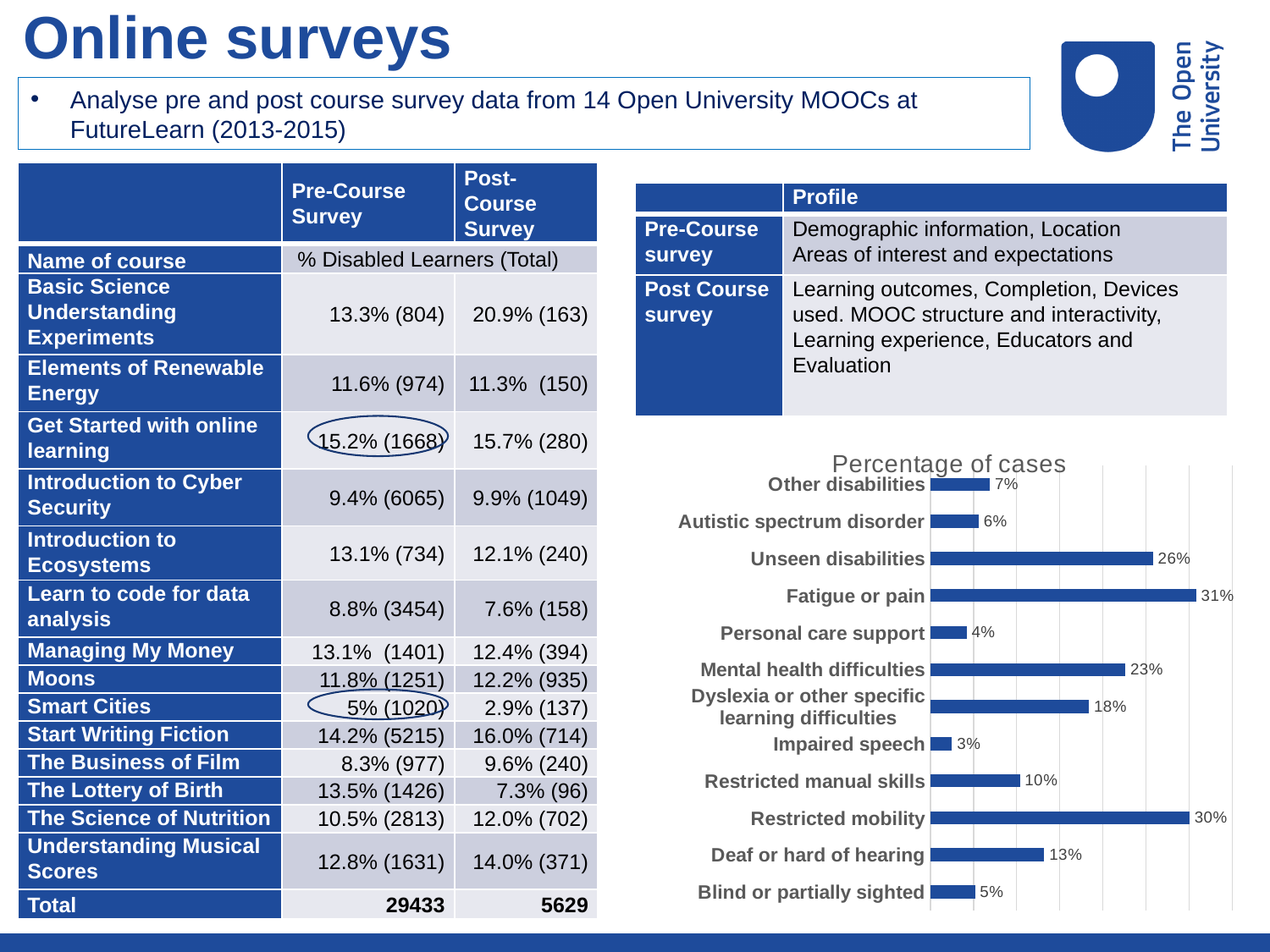
In the Percentage of cases chart, what is the difference between Unseen disabilities and Mental health difficulties? 3% What is the value for Personal care support in the Percentage of cases chart? 4% Which category has the highest value in the Percentage of cases chart? Fatigue or pain What is the value for Deaf or hard of hearing in the Percentage of cases chart? 13% In the Percentage of cases chart, which is larger: Other disabilities or Blind or partially sighted? Other disabilities What is the value for Fatigue or pain in the Percentage of cases chart? 31% What kind of chart is the Percentage of cases chart? Bar chart In the Percentage of cases chart, what is the difference between Restricted mobility and Restricted manual skills? 20% Which category has the lowest value in the Percentage of cases chart? Impaired speech In the Percentage of cases chart, which is larger: Unseen disabilities or Deaf or hard of hearing? Unseen disabilities How many categories are shown in the Percentage of cases chart? 12 What is the value for Dyslexia or other specific learning difficulties in the Percentage of cases chart? 18%